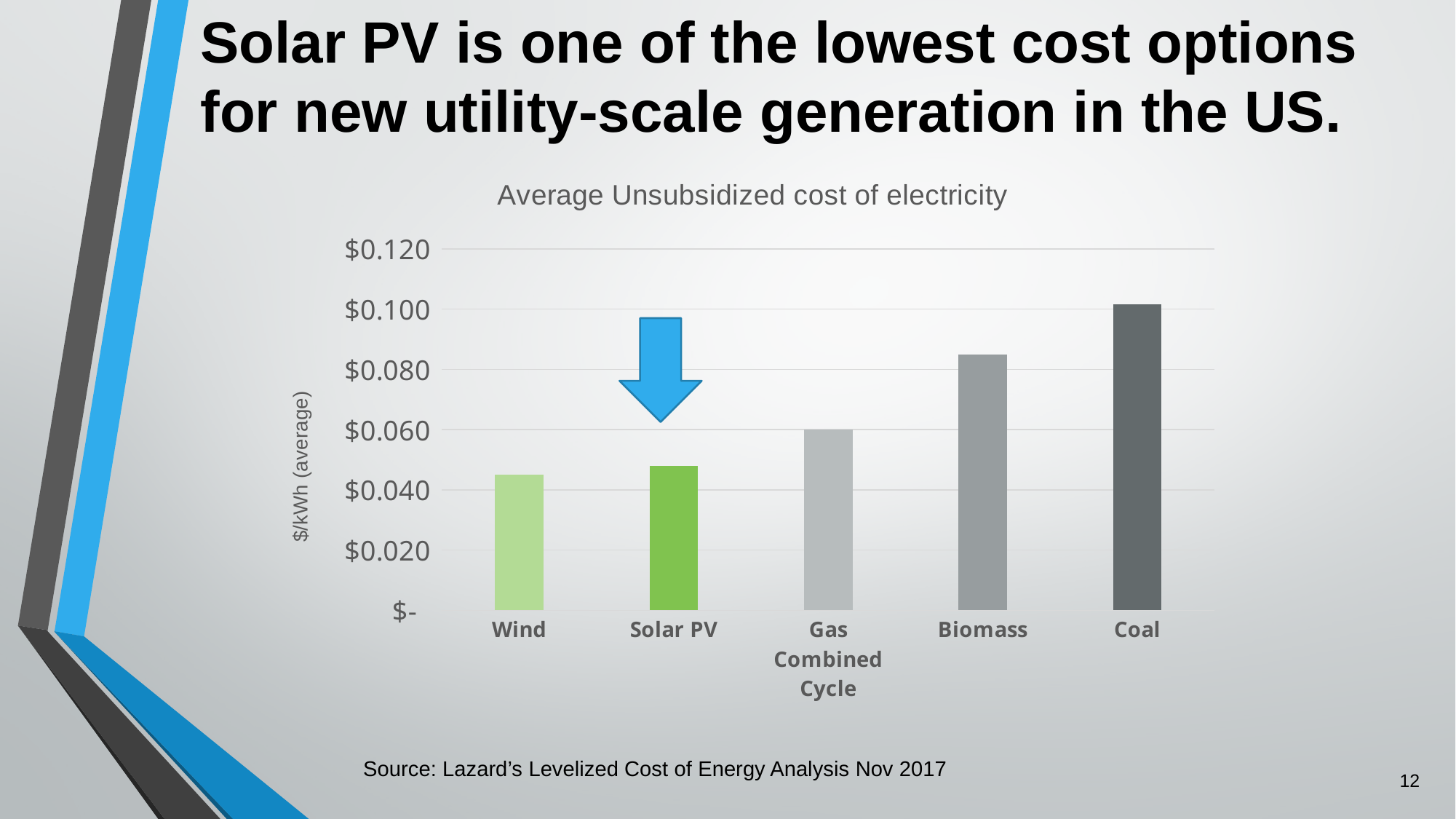
Which category has the lowest average unsubsidized cost of electricity? Wind Which category has the highest average unsubsidized cost of electricity? Coal Is the value for Wind greater or less than $0.040? greater Is the value for Solar PV greater or less than $0.060? less Is the value for Biomass greater or less than $0.080? greater What kind of chart is shown on the slide? bar chart How many categories are plotted in the chart? 5 What is the average unsubsidized cost of electricity for Gas Combined Cycle? $0.060 Which has a higher cost, Biomass or Solar PV? Biomass What is the title of the chart? Average Unsubsidized cost of electricity Do the values generally rise or fall moving from Wind on the left to Coal on the right? rise